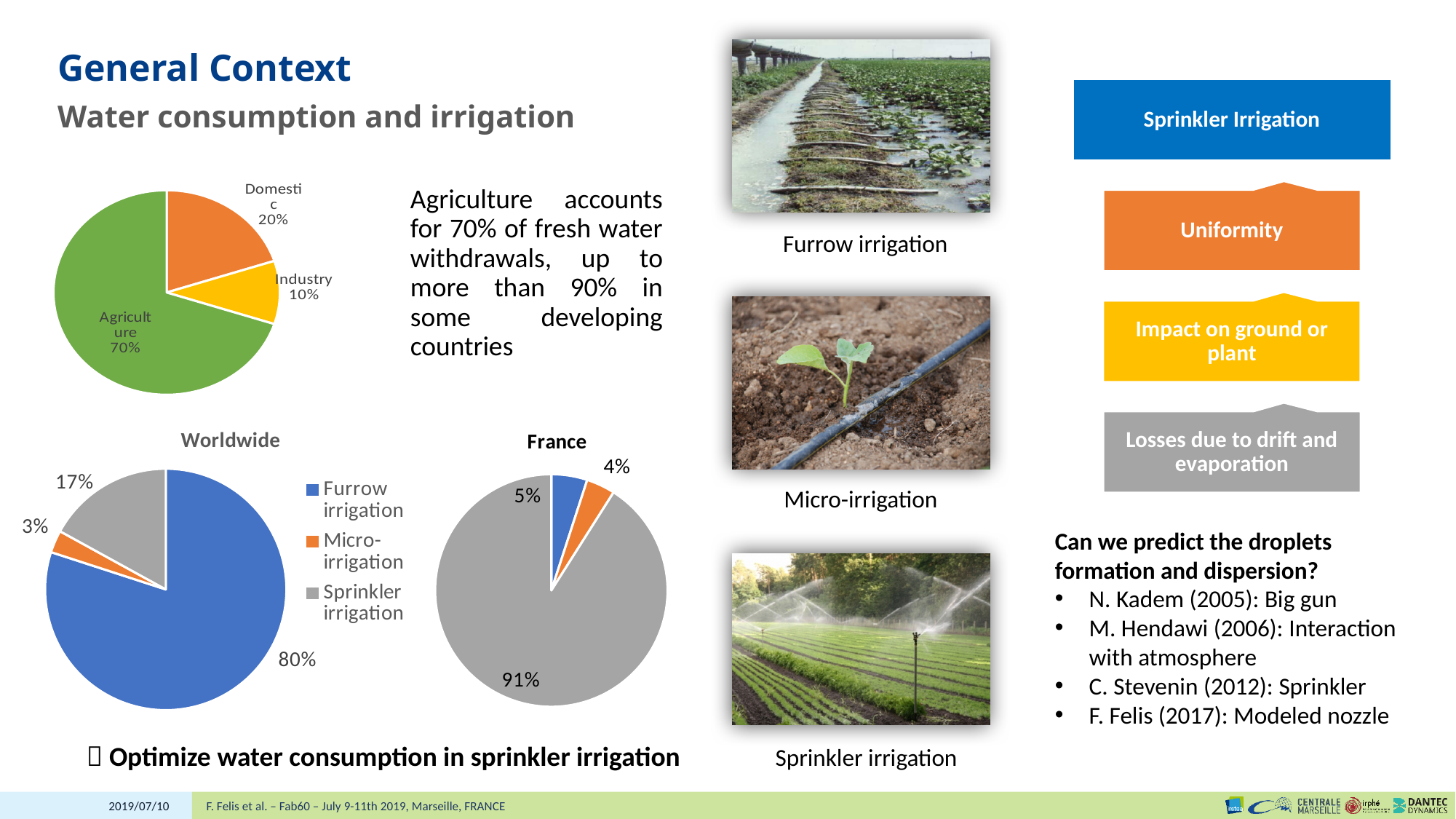
What type of chart is the Worldwide chart? Pie chart In the top-left pie chart, which category has the smallest slice? Industry In the France pie chart, which irrigation type has the smallest slice? Micro-irrigation In the top-left pie chart, what share is labelled for Industry? 10% In the top-left pie chart, what share is labelled for Agriculture? 70% How many entries does the legend between the Worldwide and France pie charts list? 3 In the top-left pie chart, how many slices are there? 3 In the France pie chart, what share is labelled for Sprinkler irrigation? 91% What is the difference between the Sprinkler irrigation share in the France chart and in the Worldwide chart? 74% In the Worldwide pie chart, what share is labelled for Furrow irrigation? 80% In the Worldwide pie chart, what share is labelled for Micro-irrigation? 3% In the Worldwide pie chart, which irrigation type has the largest slice? Furrow irrigation